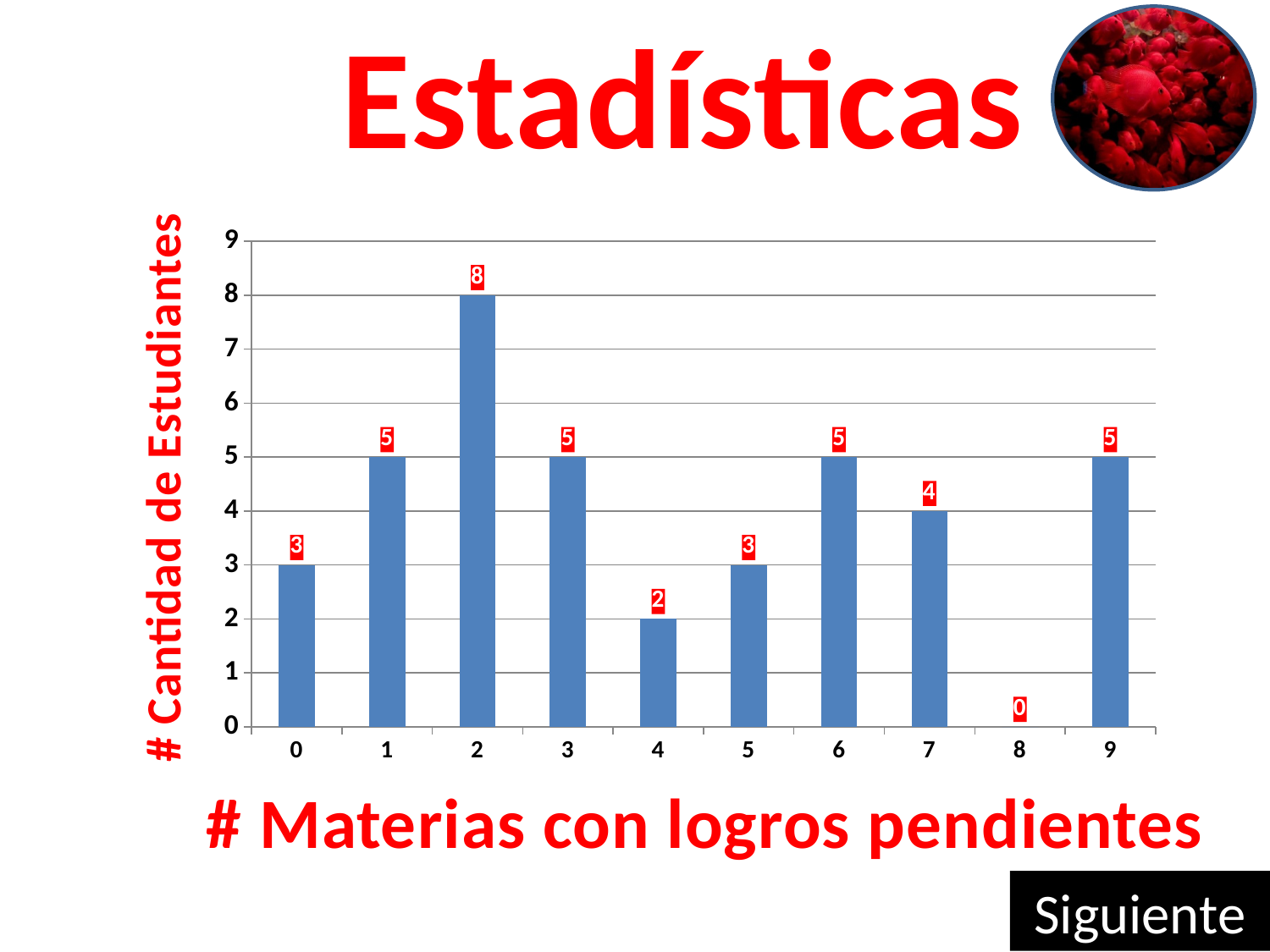
Which has a larger value, category 0 or category 7? 7 What is the label of the vertical axis? # Cantidad de Estudiantes What kind of chart is shown on the slide? bar chart What is the label of the horizontal axis? # Materias con logros pendientes Is the value for category 2 greater or less than 6? greater How many students have 2 subjects with pending achievements (category 2)? 8 What is the difference between the value for category 2 and the value for category 7? 4 Which category on the x axis has the lowest number of students? 8 How many categories are shown on the x axis? 10 What is the value for category 8 on the x axis? 0 Which category on the x axis has the highest number of students? 2 What is the value for category 4 on the x axis? 2